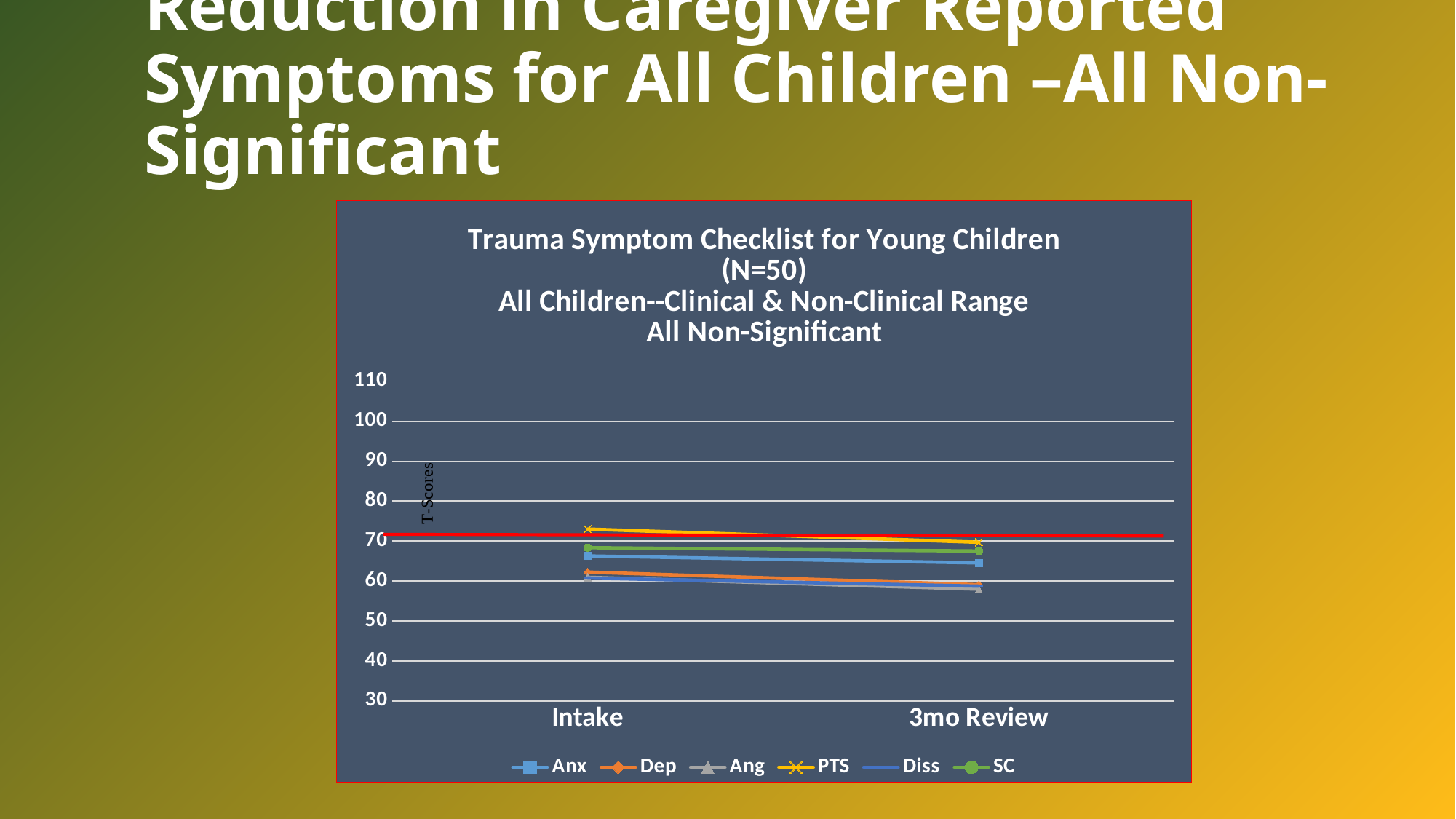
Which series has the highest value at Intake? PTS Is the value for PTS at Intake greater or less than 70? greater At 3mo Review, which is larger, the value for SC or the value for Dep? SC How many series does the legend list? 6 What is the label on the vertical axis of the chart? T-Scores Is the value for Ang at 3mo Review greater or less than 60? less Is the value for SC at Intake greater or less than 70? less At Intake, which is larger, the value for PTS or the value for Anx? PTS Which series has the highest value at 3mo Review? PTS What kind of chart is shown on the slide? line chart Does the PTS line rise or fall from Intake to 3mo Review? fall How many time points are shown on the x axis? 2